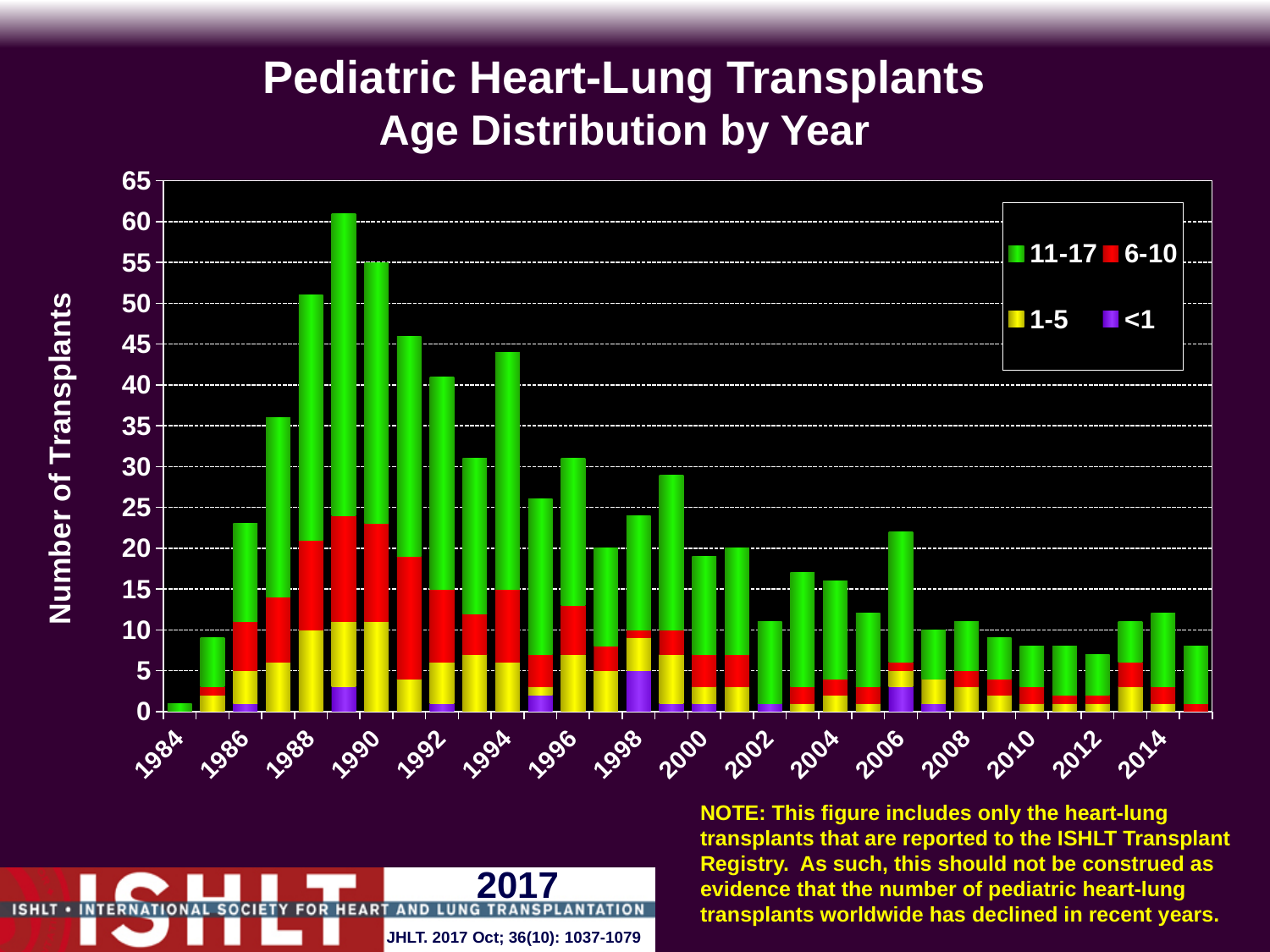
Is the total number of transplants in 1986 greater or less than 20? greater Which year has a higher total number of transplants, 1990 or 1991? 1990 Which age groups are listed in the legend? 11-17, 6-10, 1-5, <1 Which year has a higher total number of transplants, 2006 or 2007? 2006 What kind of chart is shown on the slide? Stacked bar chart Is the total number of transplants in 2002 greater or less than 15? less Which year has the lowest total number of transplants? 1984 Do the total numbers of transplants generally rise or fall from 1989 to 2015? Fall How many series does the legend list? 4 Is the total number of transplants in 1989 greater or less than 55? greater Which colour represents the 11-17 age group? Green Which year has the highest total number of transplants? 1989